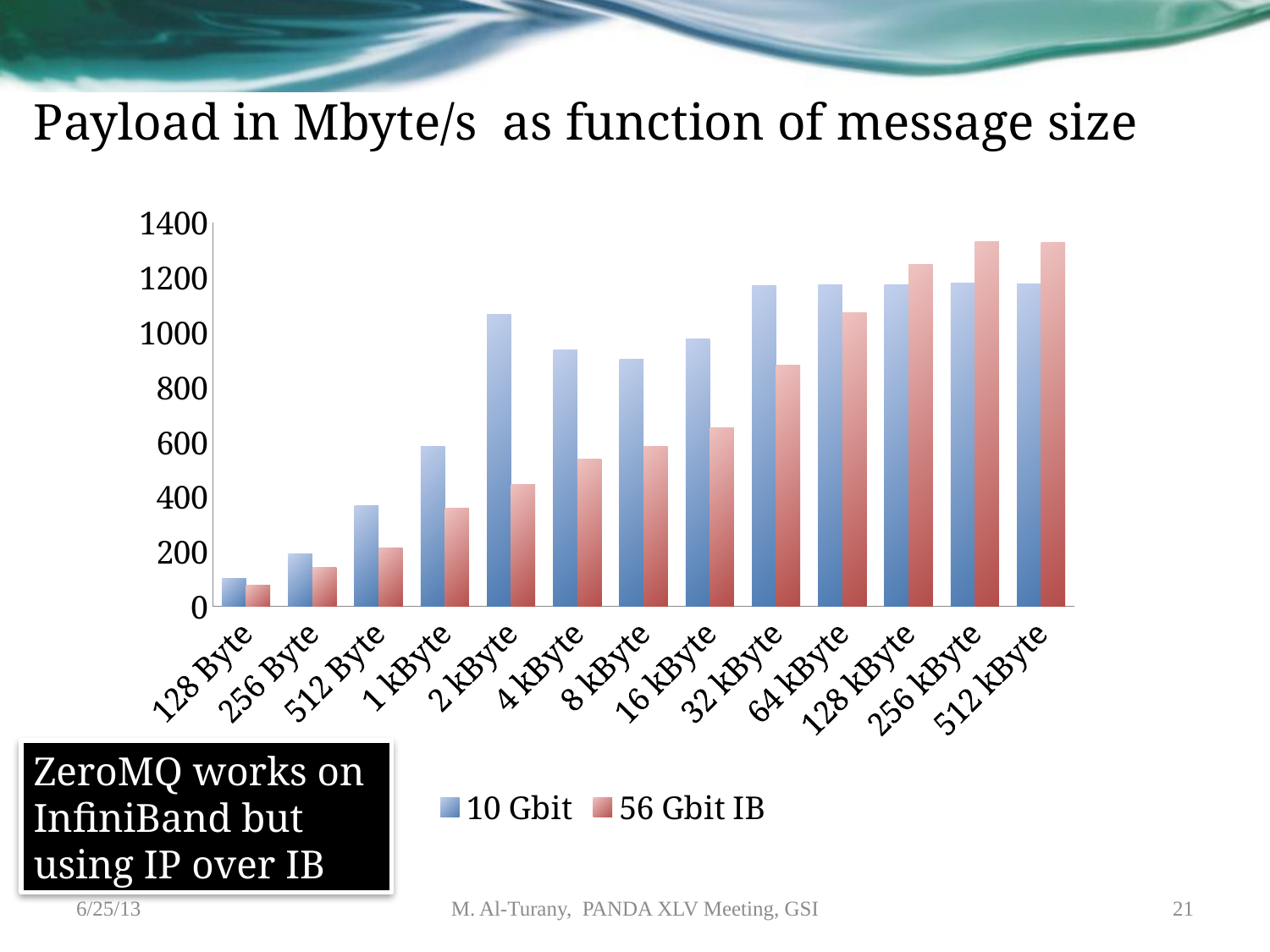
Which message size has the lowest value for the 56 Gbit IB series? 128 Byte How many series does the legend list? 2 What kind of chart is shown on the slide? bar chart What is the title of the chart? Payload in Mbyte/s as function of message size Which series is shown in red? 56 Gbit IB At 2 kByte, which series has the larger value, 10 Gbit or 56 Gbit IB? 10 Gbit Is the value for 10 Gbit at 2 kByte greater or less than 1000? greater How many message-size categories are shown on the x axis? 13 Is the value for 56 Gbit IB at 512 kByte greater or less than 1200? greater Is the value for 56 Gbit IB at 2 kByte greater or less than 600? less At 256 kByte, which series has the larger value, 10 Gbit or 56 Gbit IB? 56 Gbit IB